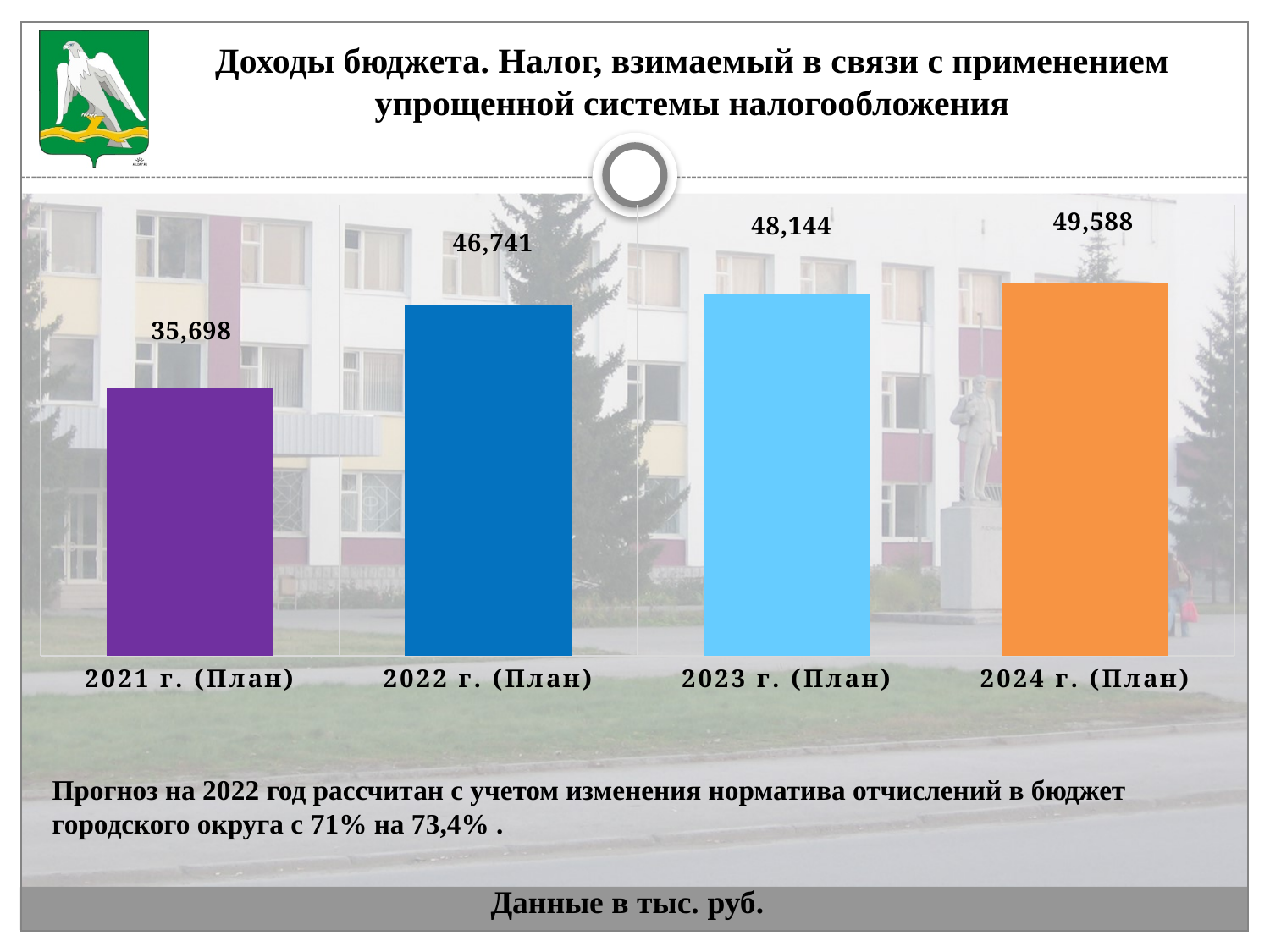
What is the value for 2023 г. (План)? 48,144 What is the difference between the values for 2024 г. (План) and 2023 г. (План)? 1,444 Which year has the lowest value? 2021 г. (План) What kind of chart is shown on the slide? Bar chart Which is larger, the value for 2022 г. (План) or 2021 г. (План)? 2022 г. (План) What is the value for 2021 г. (План)? 35,698 How many bars are shown in the chart? 4 What is the value for 2022 г. (План)? 46,741 What is the value for 2024 г. (План)? 49,588 Do the values rise or fall from 2021 to 2024? Rise What is the difference between the values for 2022 г. (План) and 2021 г. (План)? 11,043 Which year has the highest value? 2024 г. (План)